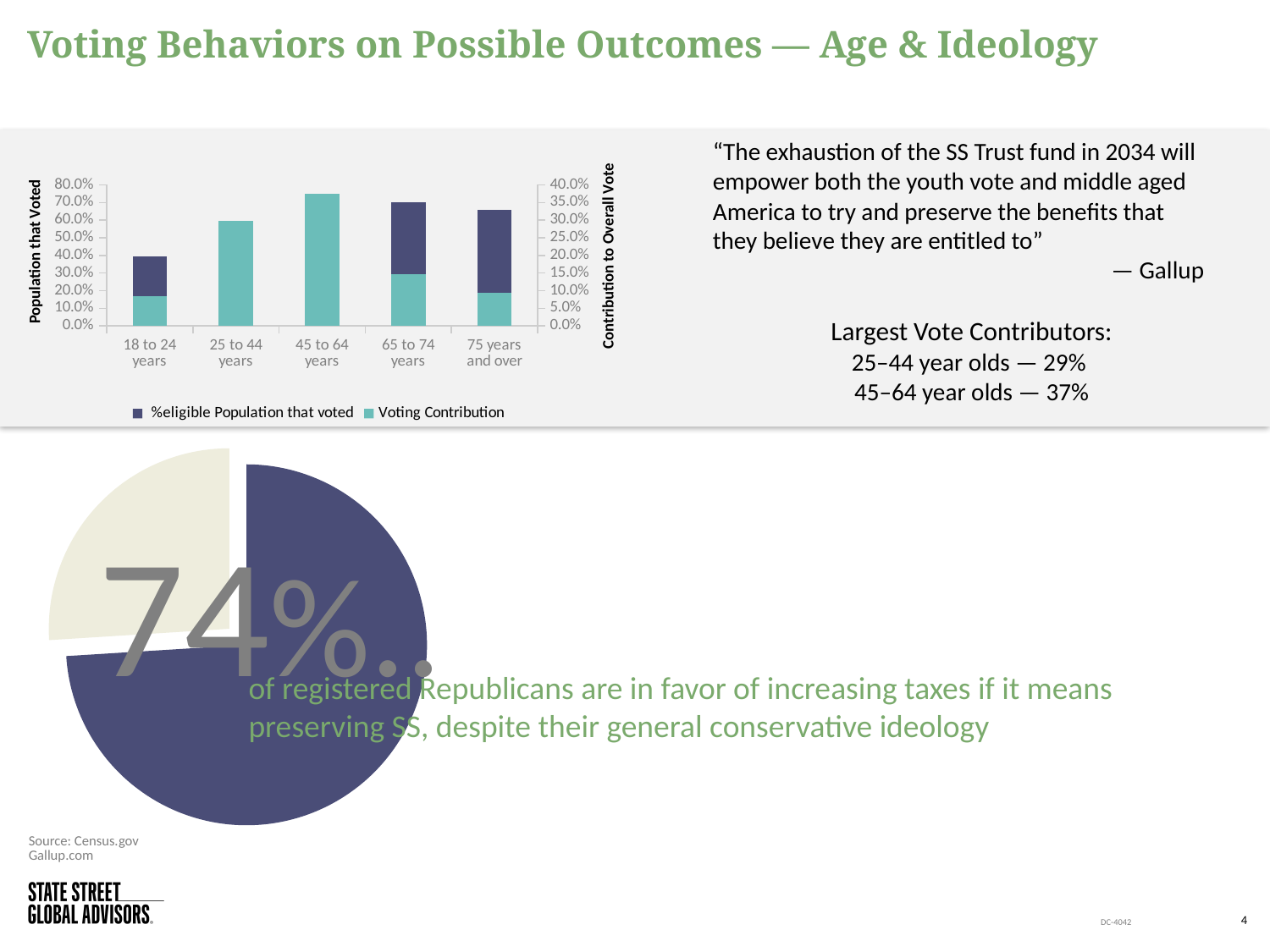
What type of chart is shown at the top left of the slide? bar chart What type of chart is shown at the bottom left of the slide? pie chart In the top-left bar chart, is the %eligible Population that voted for 75 years and over greater or less than 50.0%? greater In the top-left bar chart, how many series does the legend list? 2 In the top-left bar chart, how many age groups are shown on the x axis? 5 According to the slide, what is the Voting Contribution of 45–64 year olds? 37% In the top-left bar chart, is the Voting Contribution for 45 to 64 years greater or less than 30.0% on the right axis? greater In the top-left bar chart, is the %eligible Population that voted for 18 to 24 years greater or less than 50.0%? less In the bottom-left pie chart, what share does the large dark slice represent? 74% In the top-left bar chart, which has a higher %eligible Population that voted: 65 to 74 years or 18 to 24 years? 65 to 74 years In the top-left bar chart, what are the two legend entries? %eligible Population that voted; Voting Contribution In the top-left bar chart, which age group has the highest Voting Contribution? 45 to 64 years